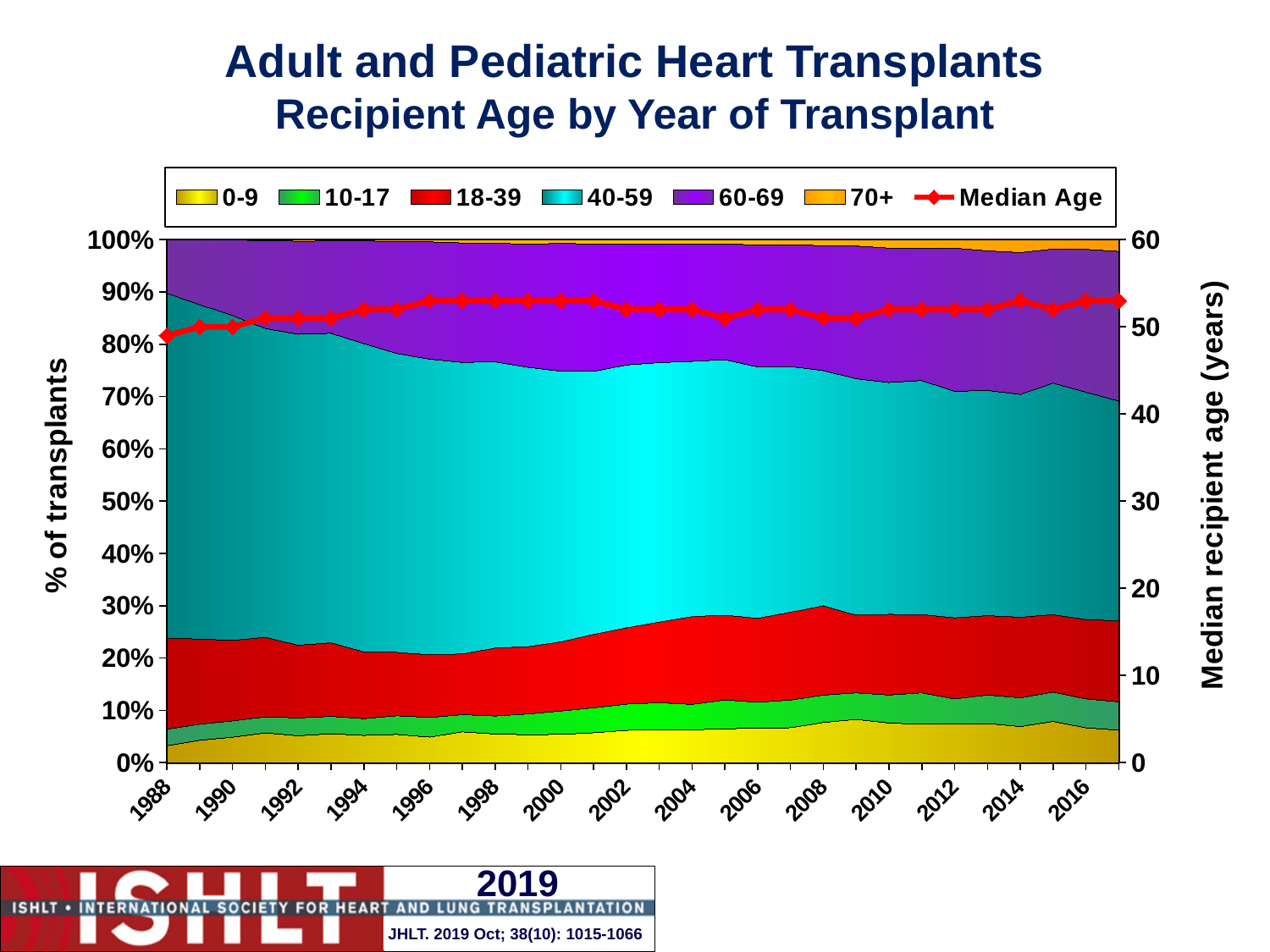
Does the share of transplants in the 60-69 age group rise or fall from 1988 to 2016? rise What is the title of the chart? Adult and Pediatric Heart Transplants Recipient Age by Year of Transplant Which age group accounts for the smallest share of transplants in 2000? 70+ What kind of chart is shown on the slide? Stacked area chart with a line for median age In 2016, which age group has the larger share of transplants, 60-69 or 18-39? 60-69 Is the median recipient age in 2016 greater or less than 50 years? greater Which age group accounts for the largest share of transplants in 2000? 40-59 Does the share of transplants in the 40-59 age group rise or fall from 1988 to 2016? fall How many series does the legend list? 7 Is the median recipient age in 2000 greater or less than 60 years? less Is the share of transplants in the 0-9 age group in 2016 greater or less than 10%? less What is the label of the right-hand vertical axis? Median recipient age (years)